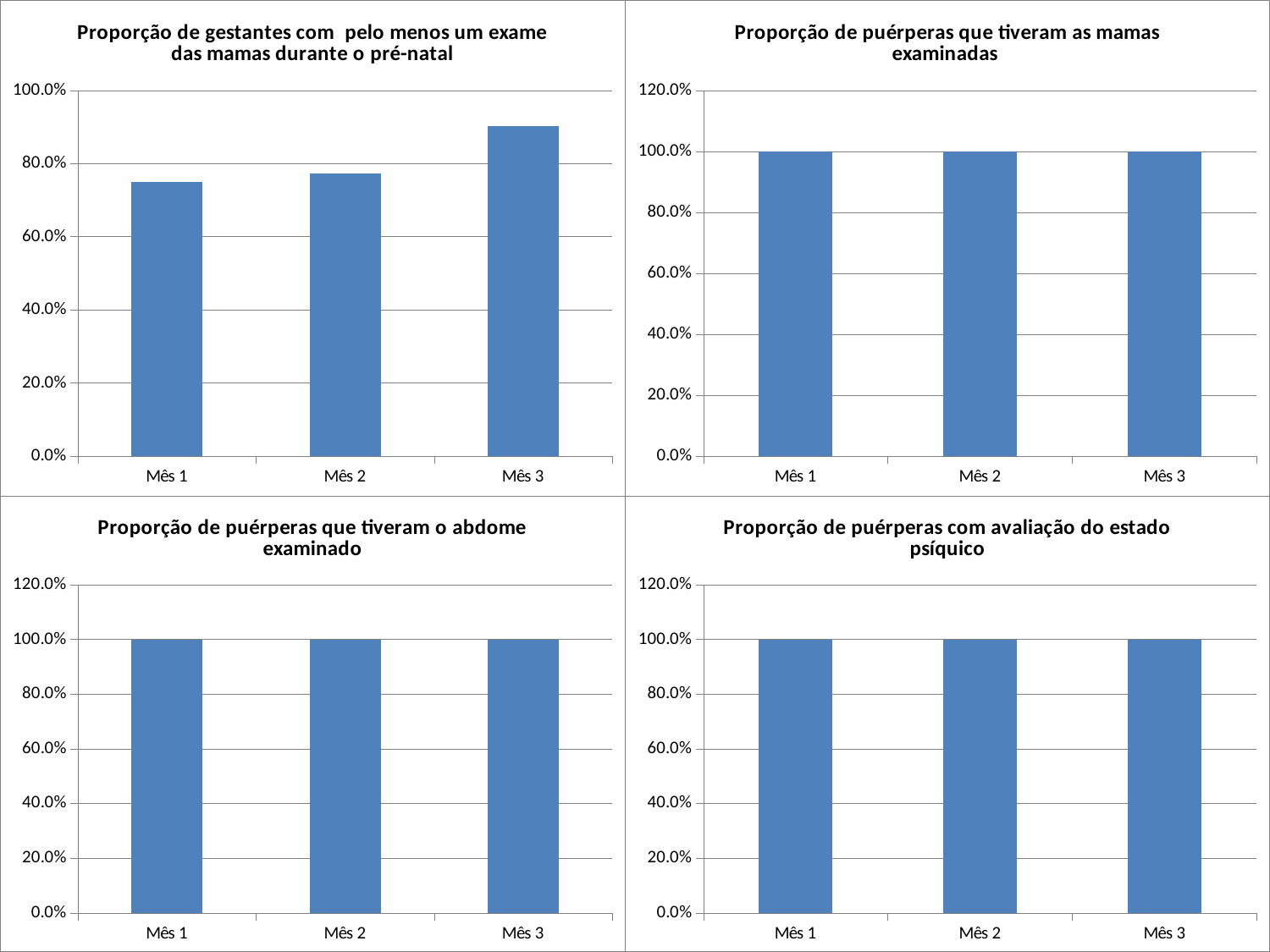
What kind of chart is the top-right chart (Proporção de puérperas que tiveram as mamas examinadas)? bar chart In the bottom-right chart (Proporção de puérperas com avaliação do estado psíquico), what is the difference between the values for Mês 1 and Mês 3? 0.0% In the top-right chart (Proporção de puérperas que tiveram as mamas examinadas), what is the value for Mês 2? 100.0% In the top-left chart (Proporção de gestantes com pelo menos um exame das mamas durante o pré-natal), is the value for Mês 3 greater or less than 80.0%? greater How many charts are shown on the slide? 4 In the bottom-right chart (Proporção de puérperas com avaliação do estado psíquico), what is the value for Mês 3? 100.0% In the top-left chart (Proporção de gestantes com pelo menos um exame das mamas durante o pré-natal), which month has the lowest value? Mês 1 How many months are shown on the x axis of the bottom-left chart (Proporção de puérperas que tiveram o abdome examinado)? 3 In the bottom-left chart (Proporção de puérperas que tiveram o abdome examinado), what is the value for Mês 1? 100.0% In the top-left chart (Proporção de gestantes com pelo menos um exame das mamas durante o pré-natal), which month has the highest value? Mês 3 In the top-left chart (Proporção de gestantes com pelo menos um exame das mamas durante o pré-natal), is the value for Mês 1 greater or less than 80.0%? less In the top-left chart (Proporção de gestantes com pelo menos um exame das mamas durante o pré-natal), do the values rise or fall from Mês 1 to Mês 3? rise